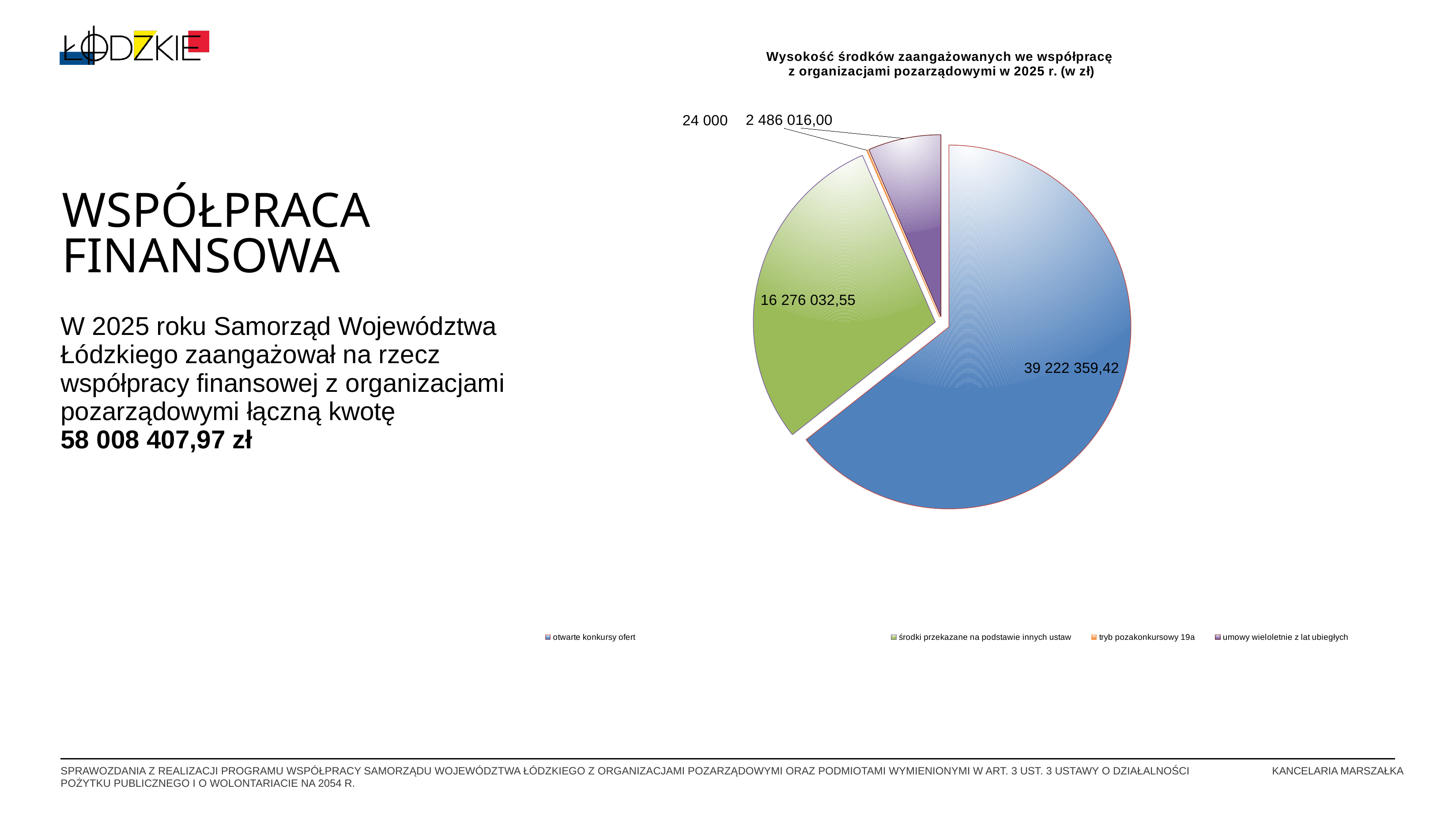
How many slices does the pie chart have? 4 What is the value for "środki przekazane na podstawie innych ustaw"? 16 276 032,55 Which category has the largest slice of the pie? otwarte konkursy ofert What is the value for "tryb pozakonkursowy 19a"? 24 000 Which category has the smallest slice of the pie? tryb pozakonkursowy 19a What is the value for "umowy wieloletnie z lat ubiegłych"? 2 486 016,00 What is the difference between the values for "otwarte konkursy ofert" and "środki przekazane na podstawie innych ustaw"? 22 946 326,87 Which is larger: the value for "umowy wieloletnie z lat ubiegłych" or the value for "tryb pozakonkursowy 19a"? umowy wieloletnie z lat ubiegłych What is the value for "otwarte konkursy ofert"? 39 222 359,42 What is the total of all the slices in the pie chart? 58 008 407,97 What is the title of the chart? Wysokość środków zaangażowanych we współpracę z organizacjami pozarządowymi w 2025 r. (w zł) What kind of chart is shown on the slide? pie chart